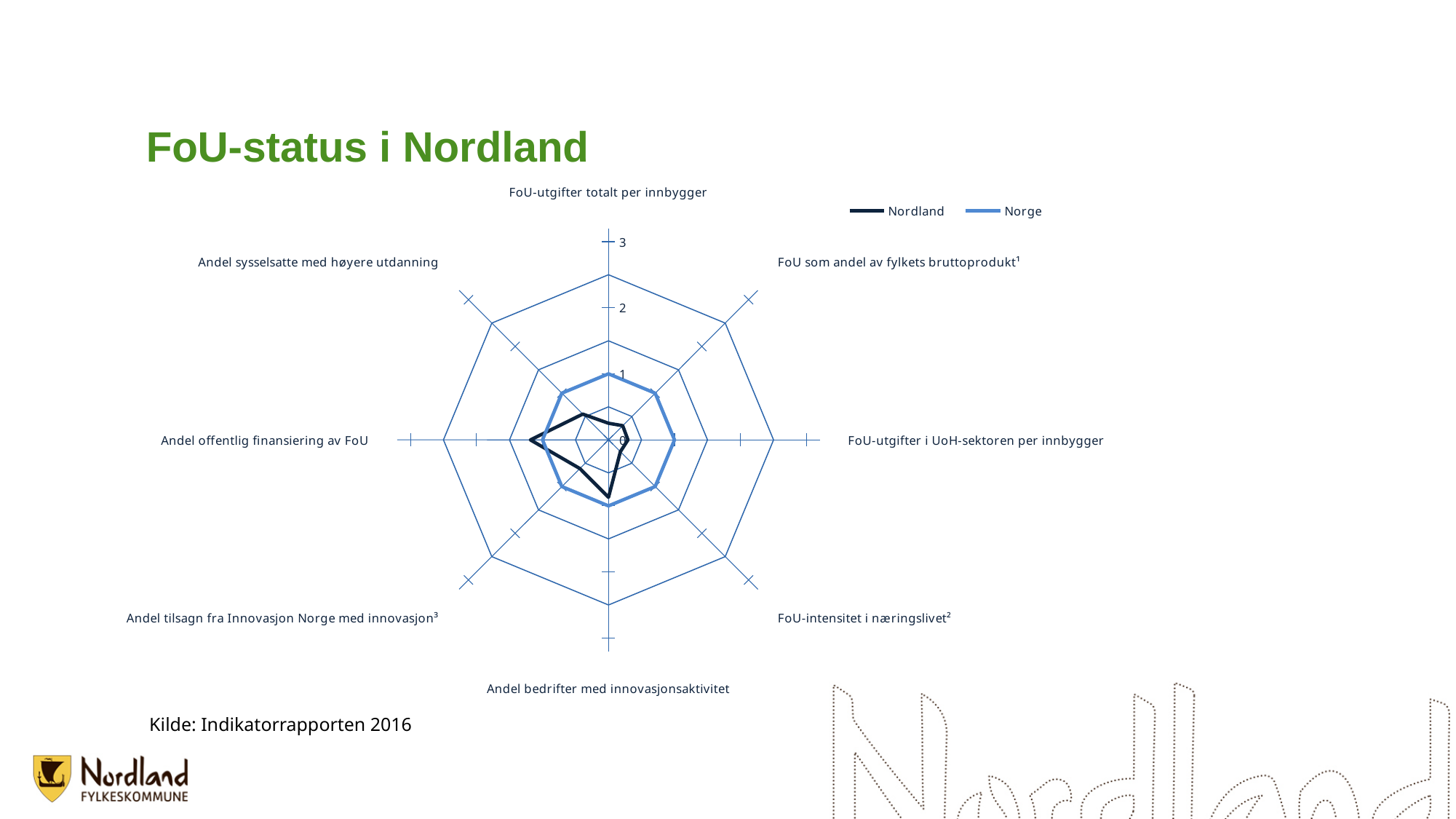
How many series does the legend list? 2 What is the Norge value for FoU-utgifter totalt per innbygger? 1 Is the Nordland value for FoU-utgifter i UoH-sektoren per innbygger greater or less than 1? less How many categories (axes) does the radar chart have? 8 Is the Nordland value for FoU-intensitet i næringslivet greater or less than 1? less On which axis does Nordland have its highest value? Andel offentlig finansiering av FoU For Andel offentlig finansiering av FoU, which series has the larger value, Nordland or Norge? Nordland For FoU-utgifter totalt per innbygger, which series has the larger value, Nordland or Norge? Norge Is the Nordland value for Andel offentlig finansiering av FoU greater or less than 1? greater What kind of chart is shown on the slide? Radar chart What is the title of the slide above the chart? FoU-status i Nordland What are the two series named in the legend? Nordland and Norge